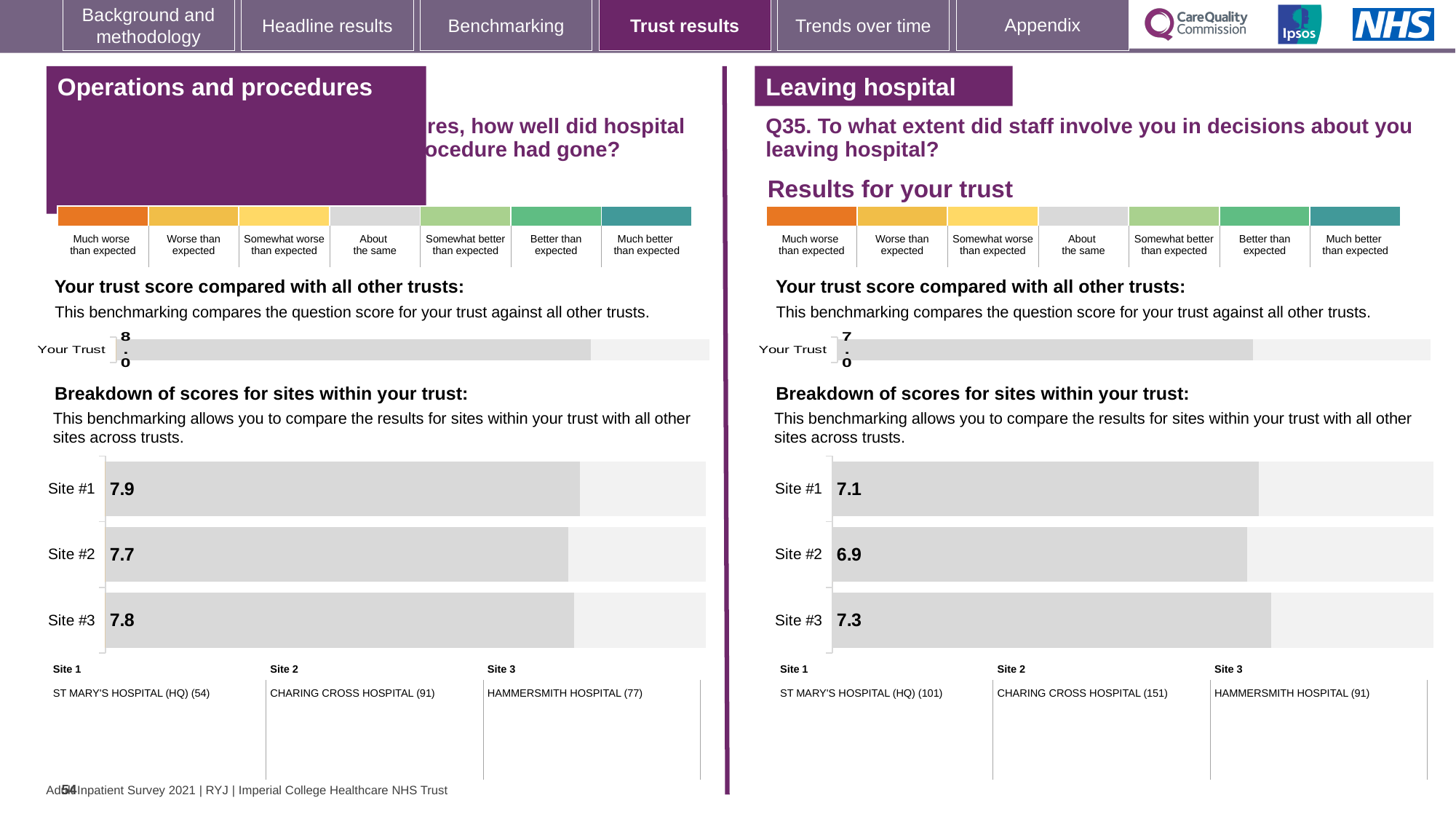
In the 'Your trust score compared with all other trusts' chart under 'Leaving hospital' (right side), what is the score for Your Trust? 7.0 What type of chart is the site breakdown chart under 'Leaving hospital' (right side)? Bar chart In the site breakdown chart under 'Operations and procedures' (left side), what is the difference between the Site #1 and Site #2 scores? 0.2 In the site breakdown chart under 'Leaving hospital' (right side), which site has the lowest score? Site #2 In the site breakdown chart under 'Leaving hospital' (right side), what is the score for Site #1? 7.1 In the site breakdown chart under 'Leaving hospital' (right side), which site has the highest score? Site #3 In the site breakdown chart under 'Operations and procedures' (left side), what is the score for Site #2? 7.7 In the site breakdown chart under 'Operations and procedures' (left side), what is the score for Site #3? 7.8 In the site breakdown chart under 'Leaving hospital' (right side), what is the score for Site #2? 6.9 How many sites are shown in the site breakdown chart under 'Operations and procedures' (left side)? 3 In the site breakdown chart under 'Leaving hospital' (right side), what is the difference between the Site #3 and Site #2 scores? 0.4 In the site breakdown chart under 'Operations and procedures' (left side), which site has the highest score? Site #1